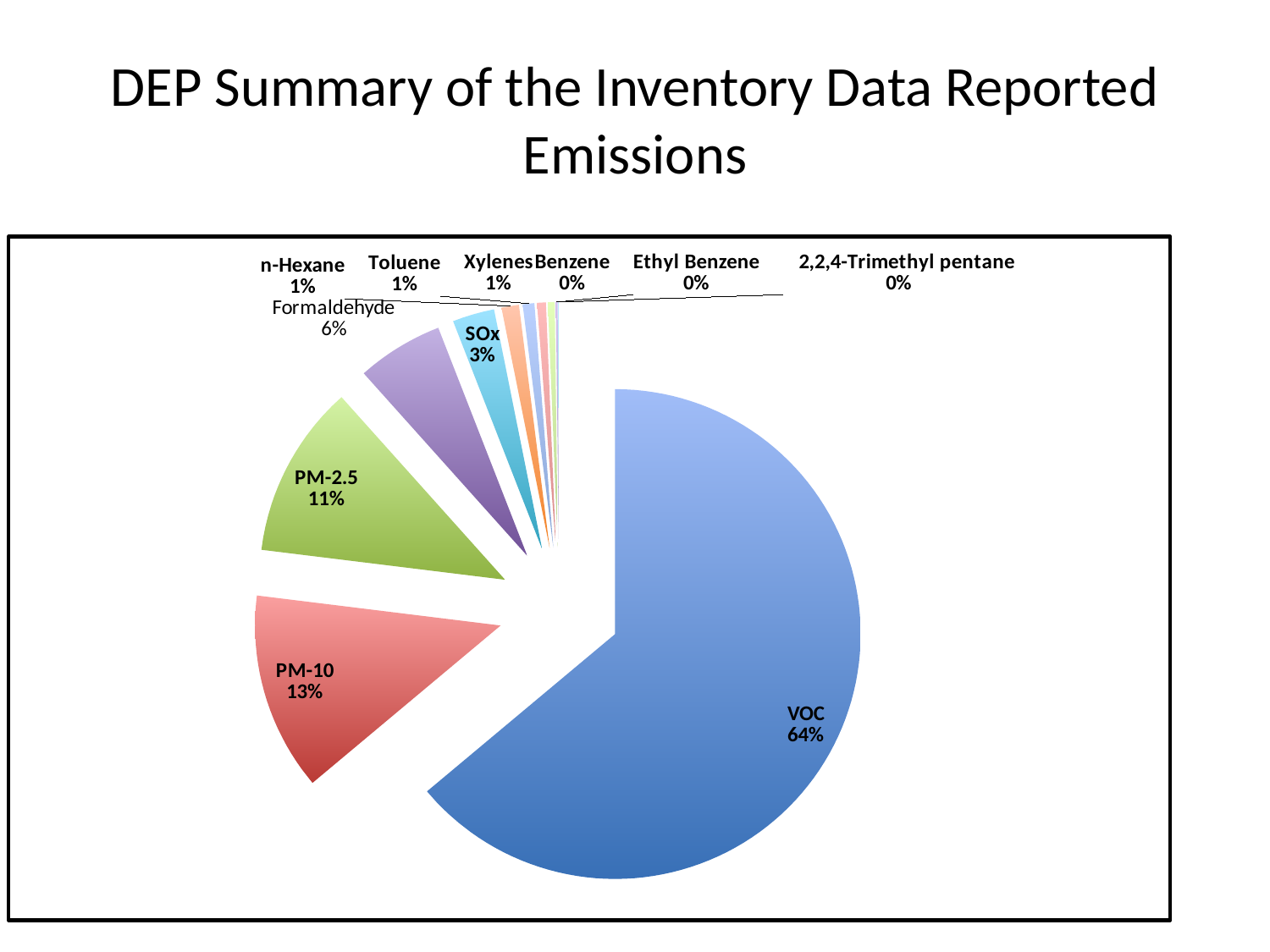
What share of the pie does VOC account for? 64% What kind of chart is shown on the slide? Pie chart Which is larger, the share for PM-10 or the share for Formaldehyde? PM-10 What is the title of the slide containing the chart? DEP Summary of the Inventory Data Reported Emissions How many categories are labelled on the pie chart? 11 What is the value shown for Toluene? 1% What is the value shown for PM-2.5? 11% What is the difference between the PM-10 share and the PM-2.5 share? 2% What is the value shown for PM-10? 13% Which category has the largest slice of the pie? VOC What is the value shown for Formaldehyde? 6% What is the value shown for SOx? 3%